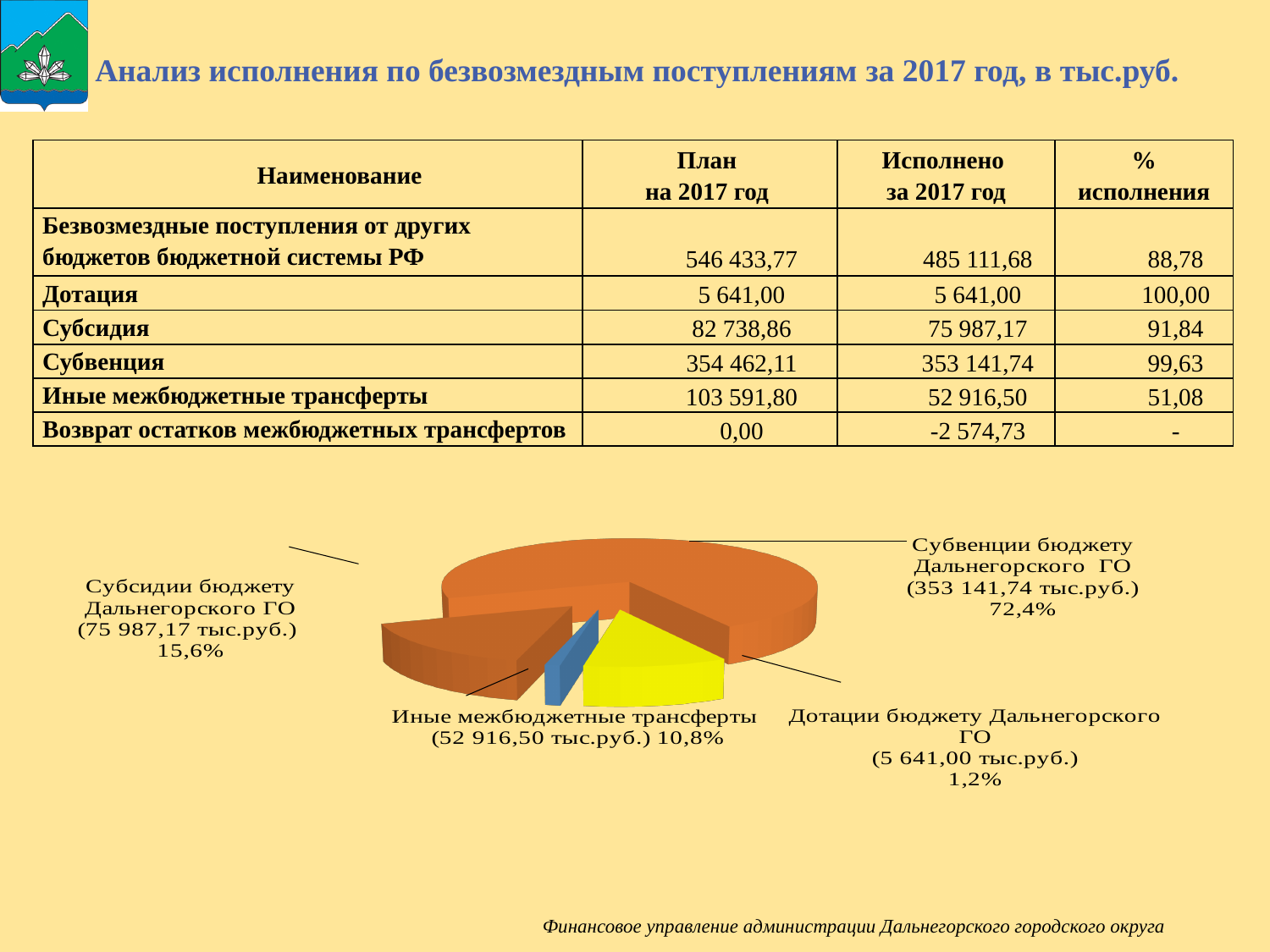
What is the difference in percentage points between the Субвенции slice (72,4%) and the Субсидии slice (15,6%) in the pie chart? 56,8 What kind of chart is shown on the slide? pie chart What share of the pie chart is taken by Дотации бюджету Дальнегорского ГО? 1,2% Which slice of the pie chart is the largest? Субвенции бюджету Дальнегорского ГО What share of the pie chart is taken by Субвенции бюджету Дальнегорского ГО? 72,4% Which is larger in the pie chart: Субсидии бюджету Дальнегорского ГО or Иные межбюджетные трансферты? Субсидии бюджету Дальнегорского ГО What value in тыс.руб. is shown for Иные межбюджетные трансферты in the pie chart? 52 916,50 тыс.руб. What share of the pie chart is taken by Иные межбюджетные трансферты? 10,8% Which slice of the pie chart is the smallest? Дотации бюджету Дальнегорского ГО What value in тыс.руб. is shown for Субвенции бюджету Дальнегорского ГО in the pie chart? 353 141,74 тыс.руб. How many slices does the pie chart have? 4